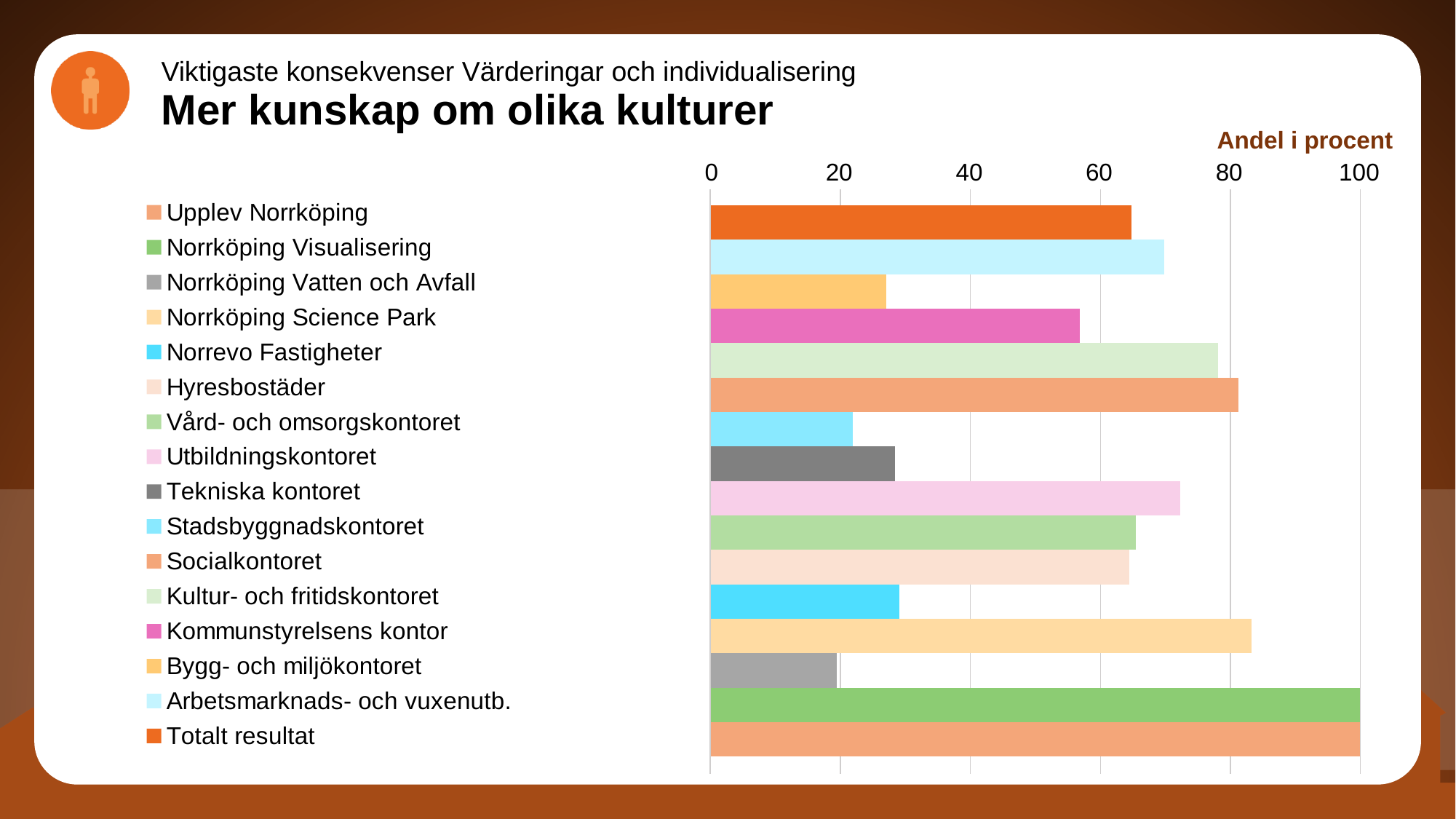
How many categories are plotted in the chart? 16 Is the value for Norrevo Fastigheter greater or less than 40? less Is the value for Utbildningskontoret greater or less than 60? greater Is the value for Totalt resultat greater or less than 60? greater What is the value for Upplev Norrköping? 100 What kind of chart is shown on the slide? bar chart What is the value for Norrköping Visualisering? 100 How many entries does the chart legend list? 16 What is the label shown above the horizontal axis of the chart? Andel i procent Which is larger, the value for Tekniska kontoret or the value for Utbildningskontoret? Utbildningskontoret Which is larger, the value for Socialkontoret or the value for Stadsbyggnadskontoret? Socialkontoret